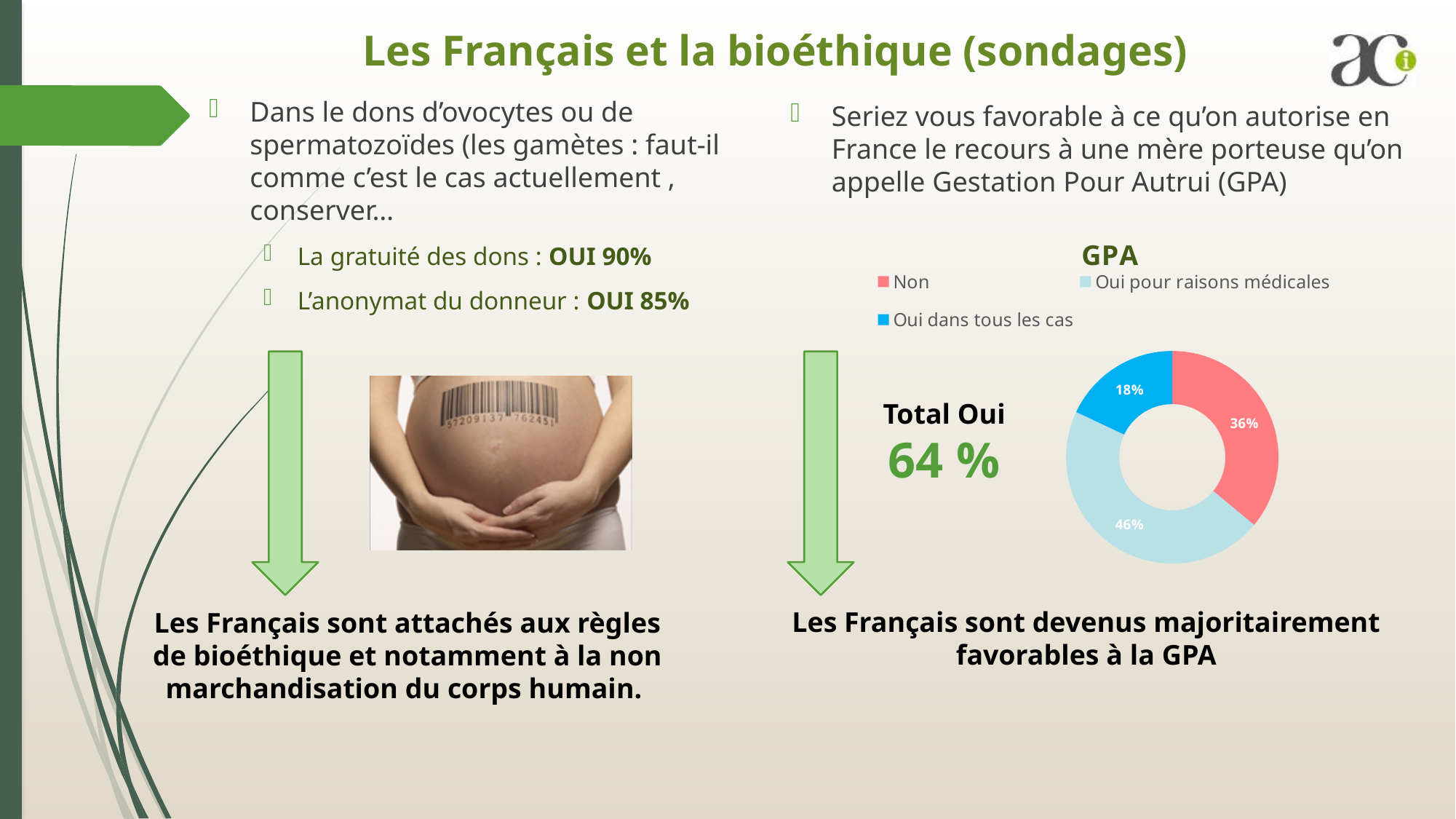
In the GPA chart, what is the value for "Oui dans tous les cas"? 18% In the GPA chart, which is larger: "Non" or "Oui dans tous les cas"? Non What kind of chart is the GPA chart? Doughnut chart In the GPA chart, which category has the smallest share? Oui dans tous les cas In the GPA chart, what is the combined share of the two "Oui" categories? 64% In the GPA chart, what is the value for "Oui pour raisons médicales"? 46% What is the title of the chart on the slide? GPA How many categories does the GPA chart show? 3 In the GPA chart, which category has the largest share? Oui pour raisons médicales In the GPA chart, what is the difference between "Oui pour raisons médicales" and "Non"? 10% In the GPA chart, what colour is the "Non" slice? Red (pink) In the GPA chart, what is the value for "Non"? 36%